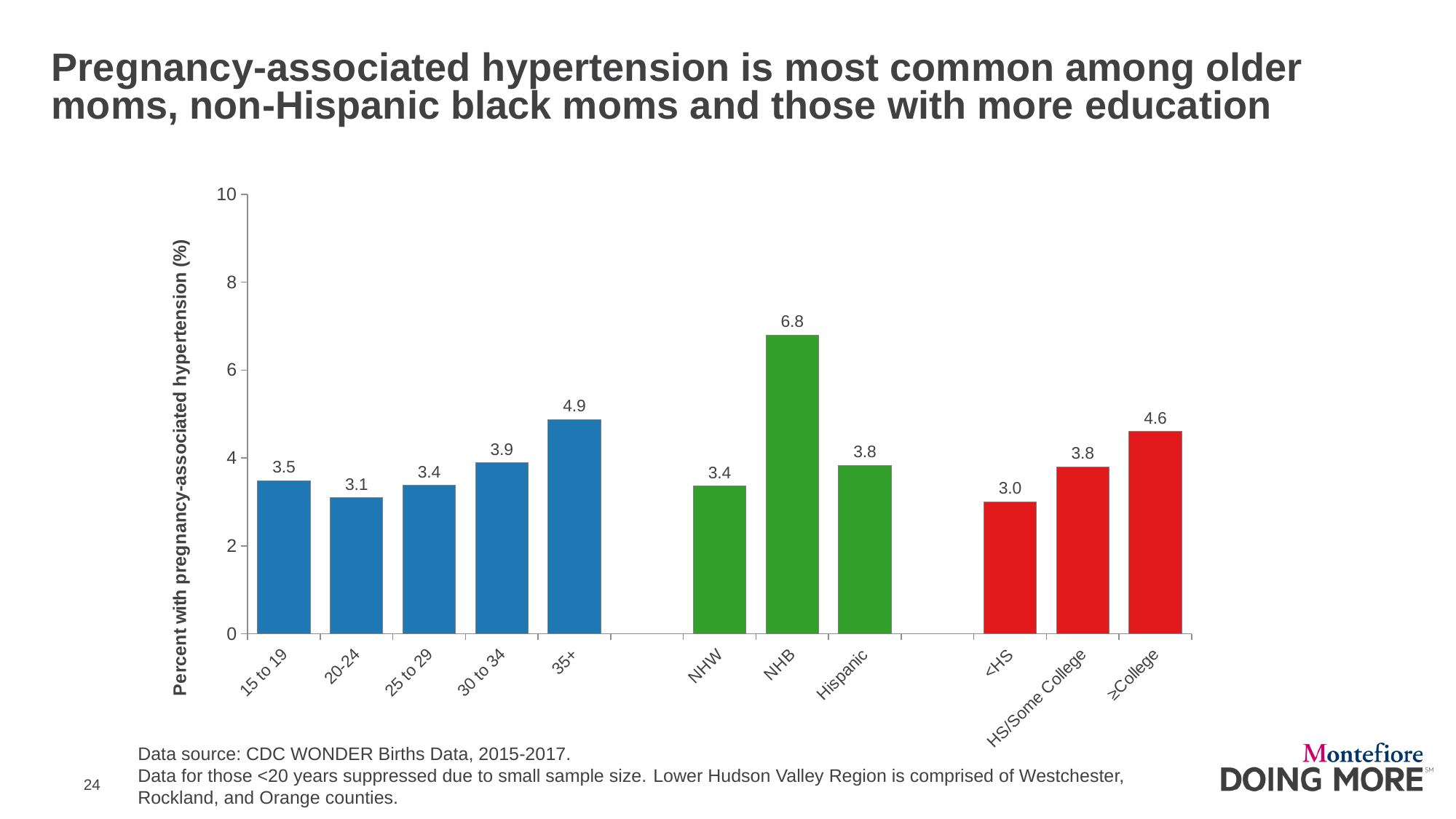
Which category has the lowest percent with pregnancy-associated hypertension? <HS Which category has the highest percent with pregnancy-associated hypertension? NHB What type of chart is shown on the slide? bar chart What is the label of the vertical axis? Percent with pregnancy-associated hypertension (%) What is the value shown for the <HS education group? 3.0 What is the percent with pregnancy-associated hypertension for the 35+ age group? 4.9 What is the difference between the values for ≥College and <HS? 1.6 How many bars are shown in the chart? 11 What is the difference between the values for NHB and NHW? 3.4 Is the value for Hispanic moms greater or less than 4? less What is the percent with pregnancy-associated hypertension for NHB moms? 6.8 Which has a higher value, the 35+ age group or the 30 to 34 age group? 35+